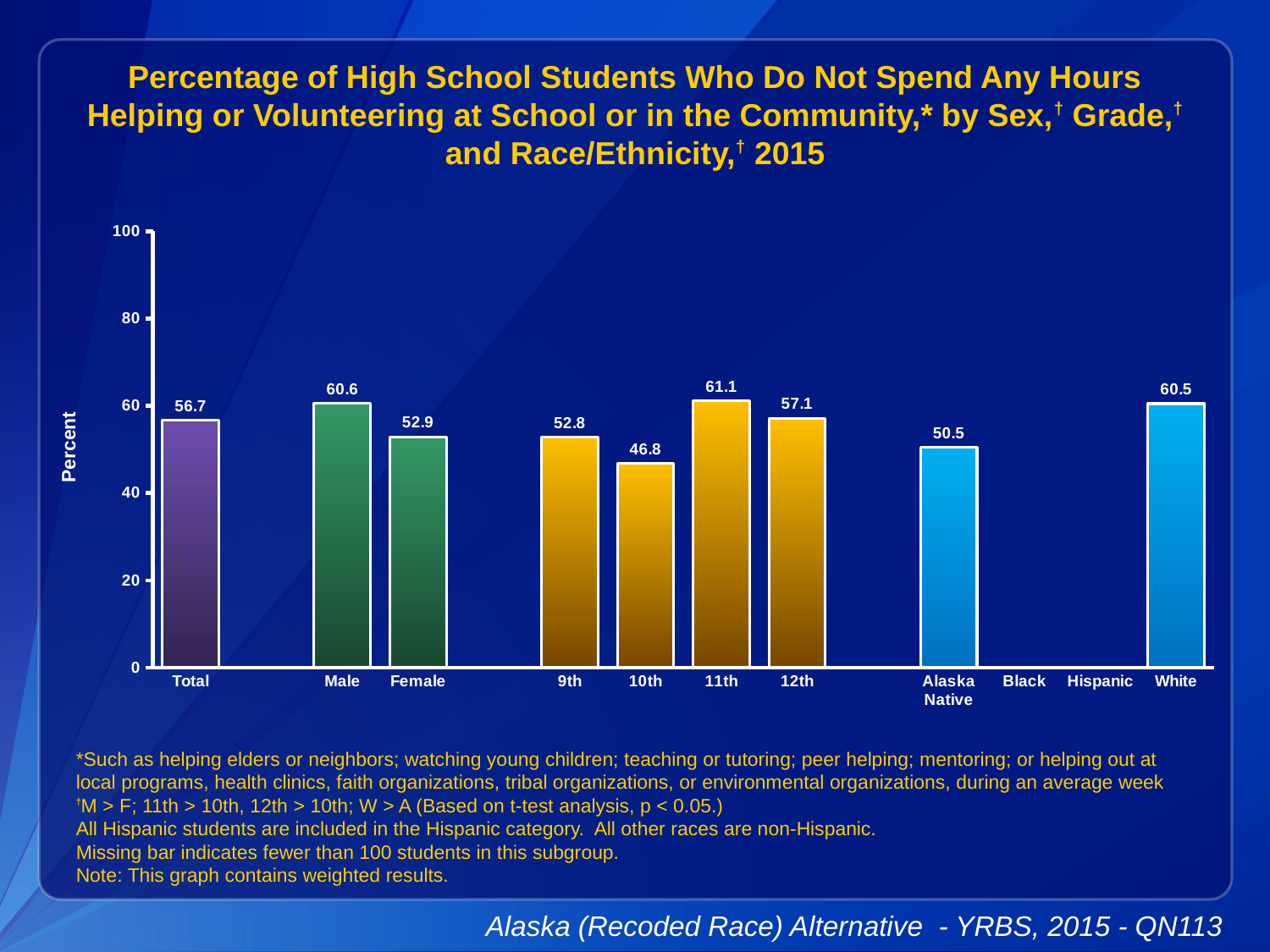
What is the value for 10th grade? 46.8 Which category has the highest value? 11th What kind of chart is shown? bar chart What is the value for Alaska Native students? 50.5 How many bars are plotted on the chart? 9 What is the value for Total? 56.7 What is the difference between the Male and Female values? 7.7 What percentage is shown for Male students? 60.6 Which categories on the x axis have no bar shown? Black and Hispanic Which category has the lowest value? 10th Is the value for White students greater or less than 60? greater Which is larger, the value for 12th grade or the value for 9th grade? 12th